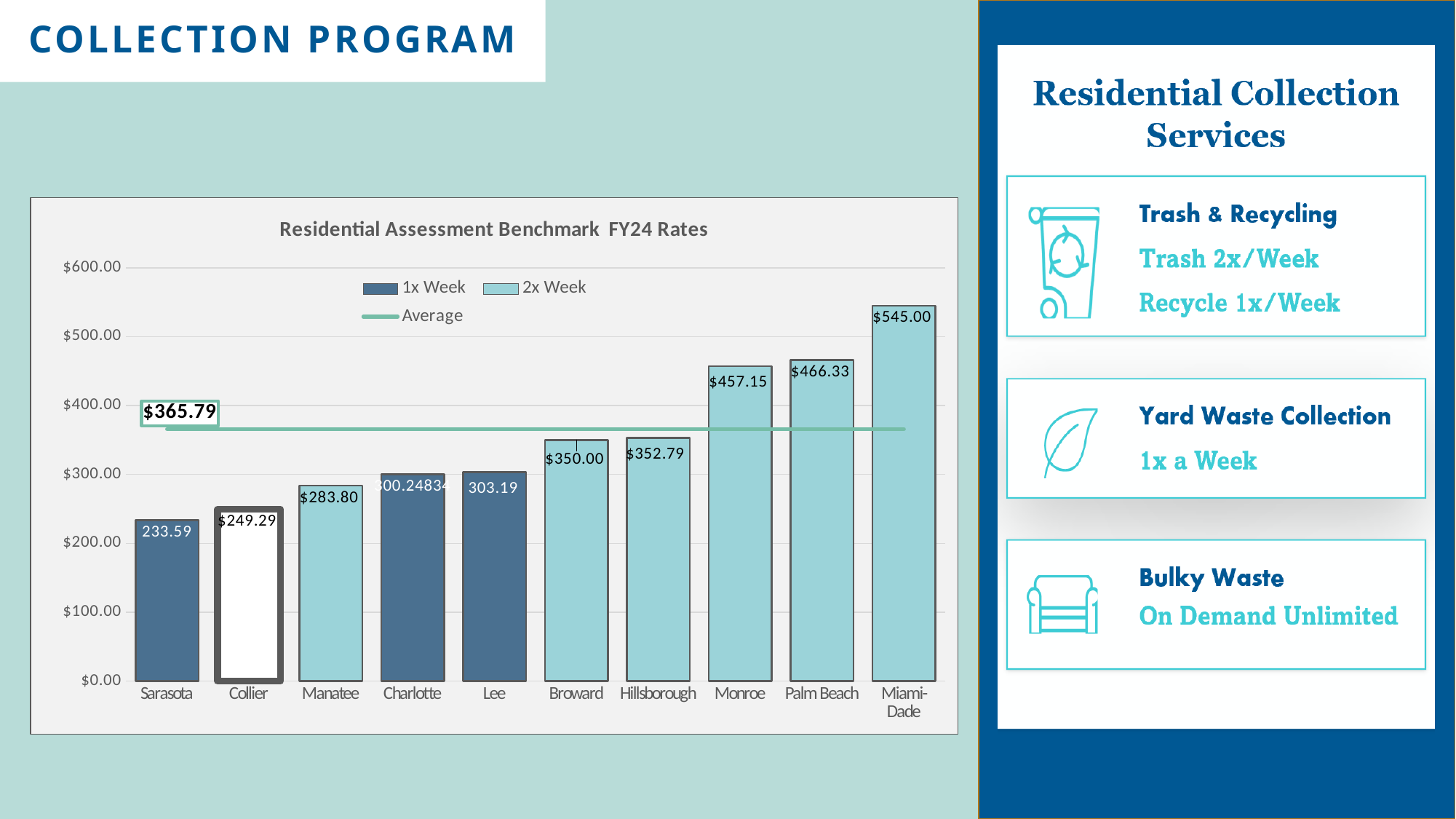
What value is shown for the Average line in the chart? $365.79 How many counties are shown on the x axis of the chart? 10 What is the value for Miami-Dade in the Residential Assessment Benchmark FY24 Rates chart? $545.00 How many entries does the chart legend list? 3 What type of chart is shown on the slide? Bar chart What is the value for Collier in the chart? $249.29 What is the value for Hillsborough in the chart? $352.79 What is the difference between the Palm Beach and Monroe values? $9.18 Is the value for Monroe greater or less than $400.00? greater Which county has the lowest rate in the chart? Sarasota Which is larger, the value for Manatee or the value for Broward? Broward Which county has the highest rate in the chart? Miami-Dade